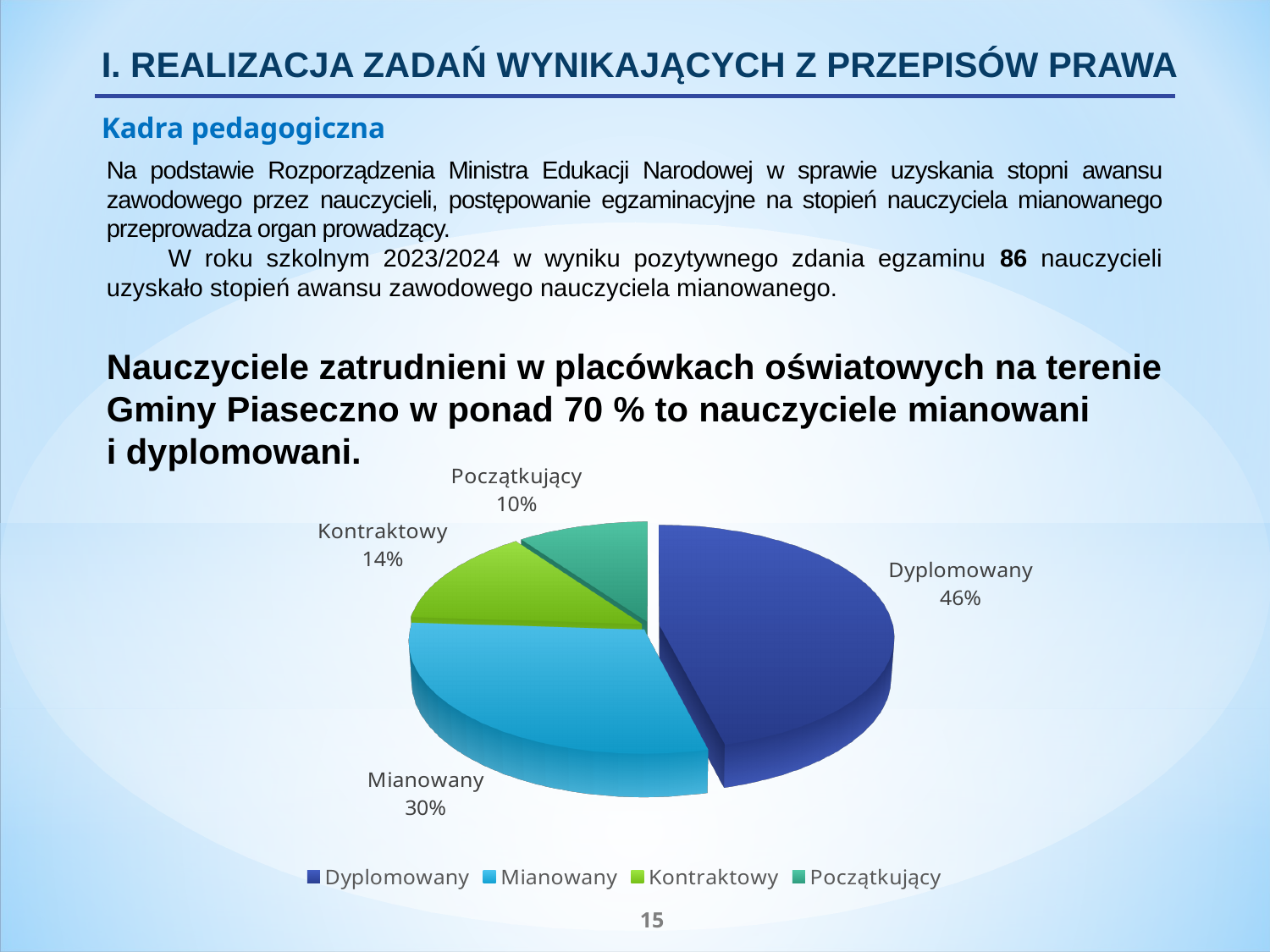
What share of the pie does Dyplomowany hold? 46% Which is larger, the share for Kontraktowy or the share for Początkujący? Kontraktowy Which category has the largest slice of the pie? Dyplomowany What colour is the Mianowany slice in the pie chart? Light blue What kind of chart is shown on the slide? Pie chart What is the difference in percentage points between Dyplomowany and Mianowany? 16 What share of the pie does Początkujący hold? 10% Which category has the smallest slice of the pie? Początkujący What share of the pie does Kontraktowy hold? 14% How many categories are shown in the pie chart? 4 What share of the pie does Mianowany hold? 30% What is the combined share of Dyplomowany and Mianowany? 76%